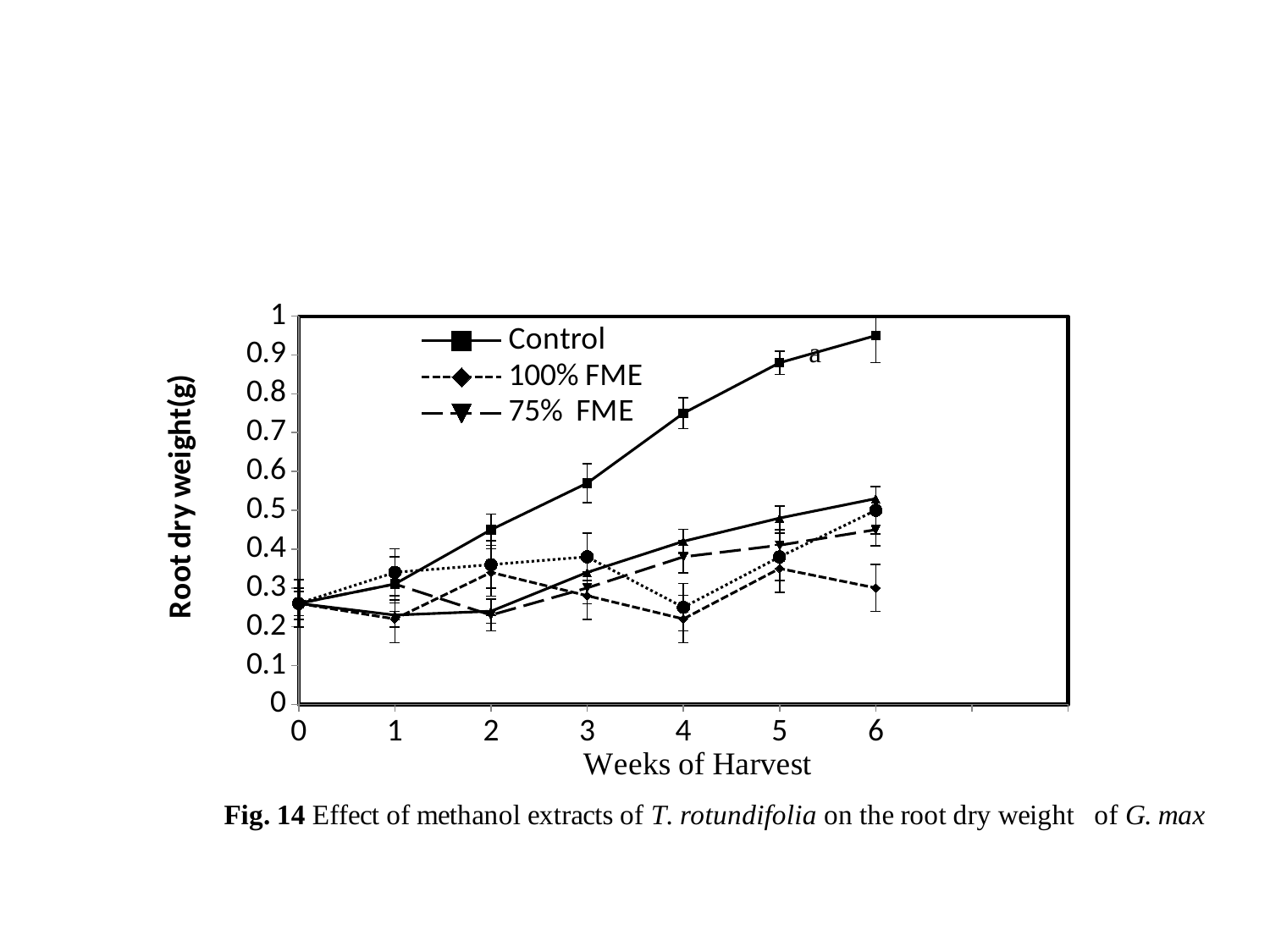
Is the 100% FME value at week 6 greater or less than 0.4? less What kind of chart is shown on the slide? line chart What is the label of the y axis? Root dry weight(g) How many weeks of harvest are plotted along the x axis (from 0 to 6)? 7 Which series has the highest root dry weight at week 6? Control At week 6, which is larger: the Control value or the 100% FME value? Control Is the Control value at week 3 greater or less than 0.5? greater Is the Control value at week 6 greater or less than 0.9? greater How many series does the legend list? 3 Does the Control series rise or fall from week 0 to week 6? rise What is the label of the x axis? Weeks of Harvest